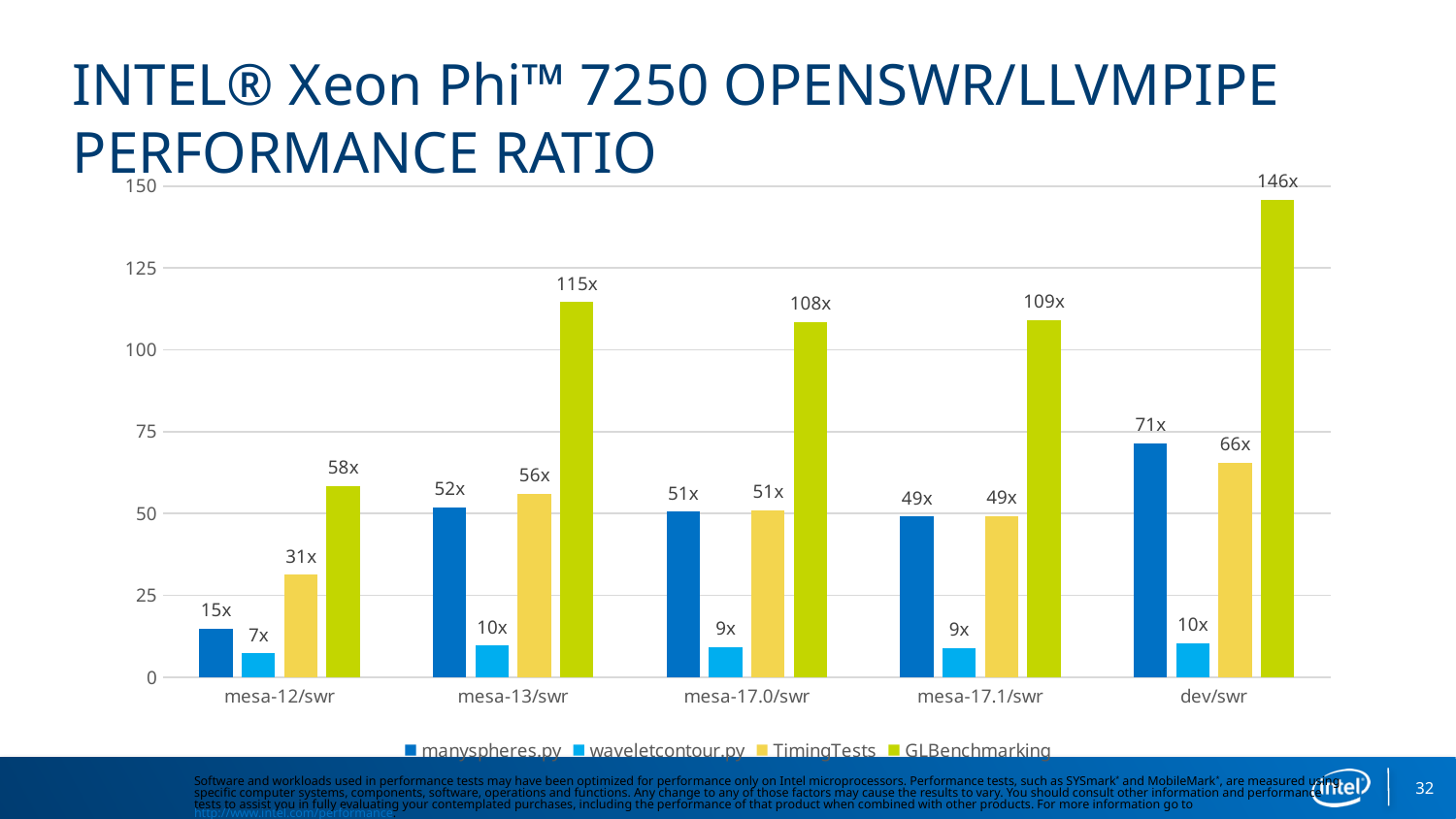
Which category has the highest GLBenchmarking value? dev/swr Which series is shown in green in the legend? GLBenchmarking What is the manyspheres.py value for mesa-13/swr? 52x What is the difference between the GLBenchmarking values for dev/swr and mesa-13/swr? 31x Which is larger, the TimingTests value for mesa-13/swr or for dev/swr? dev/swr Which category has the lowest manyspheres.py value? mesa-12/swr What is the TimingTests value for mesa-17.1/swr? 49x What is the waveletcontour.py value for mesa-12/swr? 7x What kind of chart is shown on the slide? Bar chart What is the GLBenchmarking value for dev/swr? 146x How many categories are shown on the x axis? 5 How many series does the legend list? 4